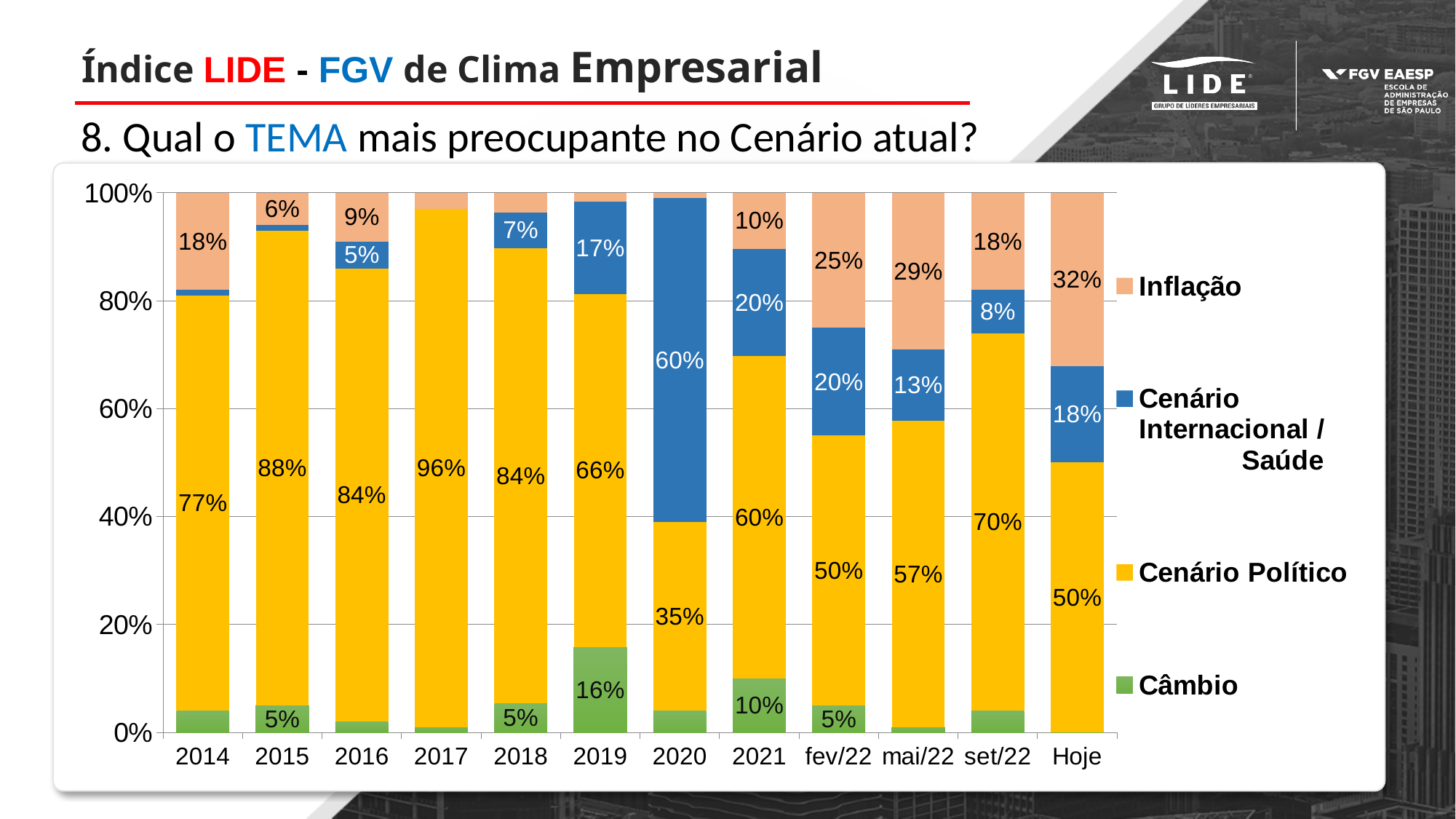
What percentage of respondents chose Cenário Político in 2017? 96% In which year or period is the Cenário Político share the highest? 2017 What is the value for Inflação in the Hoje bar? 32% How many series does the legend list? 4 How many time periods are shown on the x axis? 12 What kind of chart is shown on the slide? Stacked bar chart By how many percentage points did Inflação change from set/22 to Hoje? 14 percentage points Does the Cenário Político share rise or fall from 2017 to 2020? Fall In which year or period is the Cenário Político share the lowest? 2020 Which is larger in 2020: Cenário Político or Cenário Internacional / Saúde? Cenário Internacional / Saúde What share did Cenário Internacional / Saúde have in 2020? 60% What is the value for Câmbio in 2019? 16%